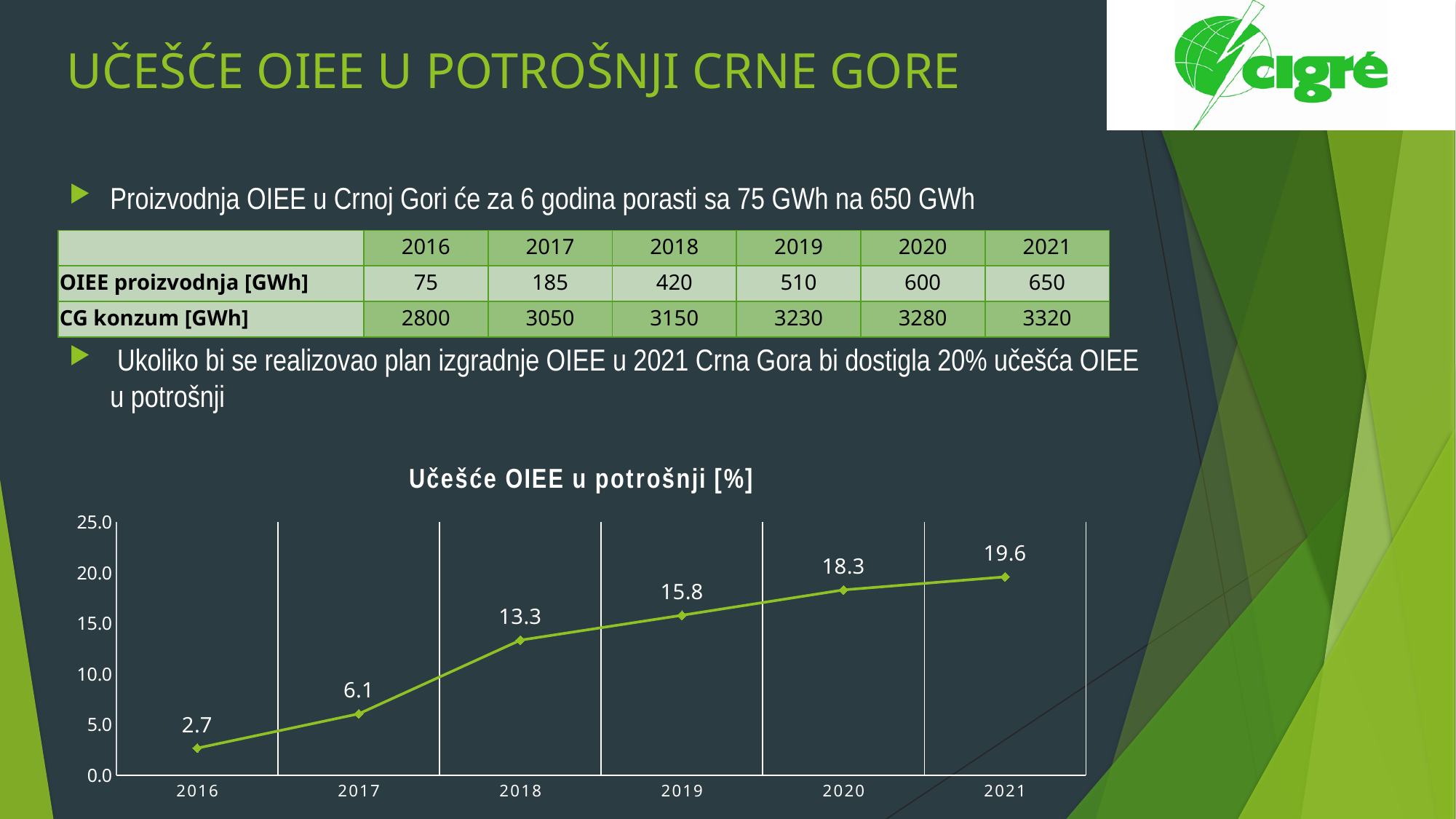
In the chart 'Učešće OIEE u potrošnji [%]', which is larger: the value for 2019 or the value for 2020? 2020 What is the difference between the values for 2021 and 2016 in the chart 'Učešće OIEE u potrošnji [%]'? 16.9 What is the difference between the values for 2018 and 2017 in the chart 'Učešće OIEE u potrošnji [%]'? 7.2 What is the value for 2016 in the chart 'Učešće OIEE u potrošnji [%]'? 2.7 What is the value for 2018 in the chart 'Učešće OIEE u potrošnji [%]'? 13.3 What is the value for 2021 in the chart 'Učešće OIEE u potrošnji [%]'? 19.6 What kind of chart is 'Učešće OIEE u potrošnji [%]'? line chart Which year has the lowest value in the chart 'Učešće OIEE u potrošnji [%]'? 2016 Which year has the highest value in the chart 'Učešće OIEE u potrošnji [%]'? 2021 Is the value for 2020 in the chart 'Učešće OIEE u potrošnji [%]' greater or less than 20.0? less Do the values in the chart 'Učešće OIEE u potrošnji [%]' rise or fall from 2016 to 2021? rise How many years are plotted in the chart 'Učešće OIEE u potrošnji [%]'? 6